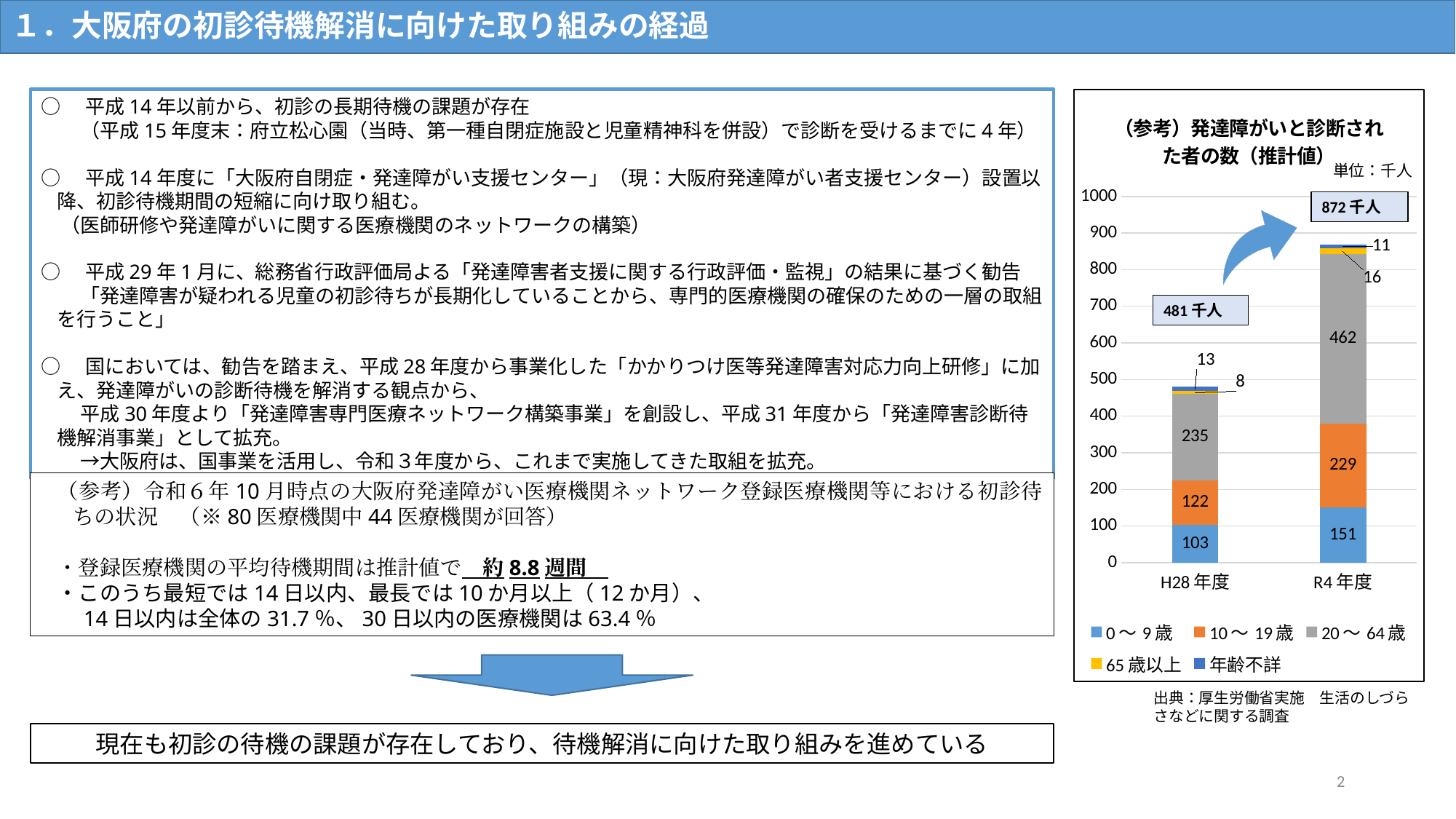
H28年度の中で最も値が小さい年齢区分はどれですか？ 65歳以上 H28年度の合計（千人）はいくつと表示されていますか？ 481千人 R4年度と H28年度の20～64歳の値の差はいくつですか？ 227 このグラフはどの種類のグラフですか？ 積み上げ棒グラフ R4年度の20～64歳の値はいくつですか？ 462 グラフの単位は何ですか？ 千人 R4年度の中で最も値が大きい年齢区分はどれですか？ 20～64歳 H28年度の0～9歳の値はいくつですか？ 103 10～19歳の値は H28年度と R4年度のどちらが大きいですか？ R4年度 凡例にはいくつの系列が示されていますか？ 5 R4年度の合計（千人）はいくつと表示されていますか？ 872千人 R4年度の10～19歳の値はいくつですか？ 229